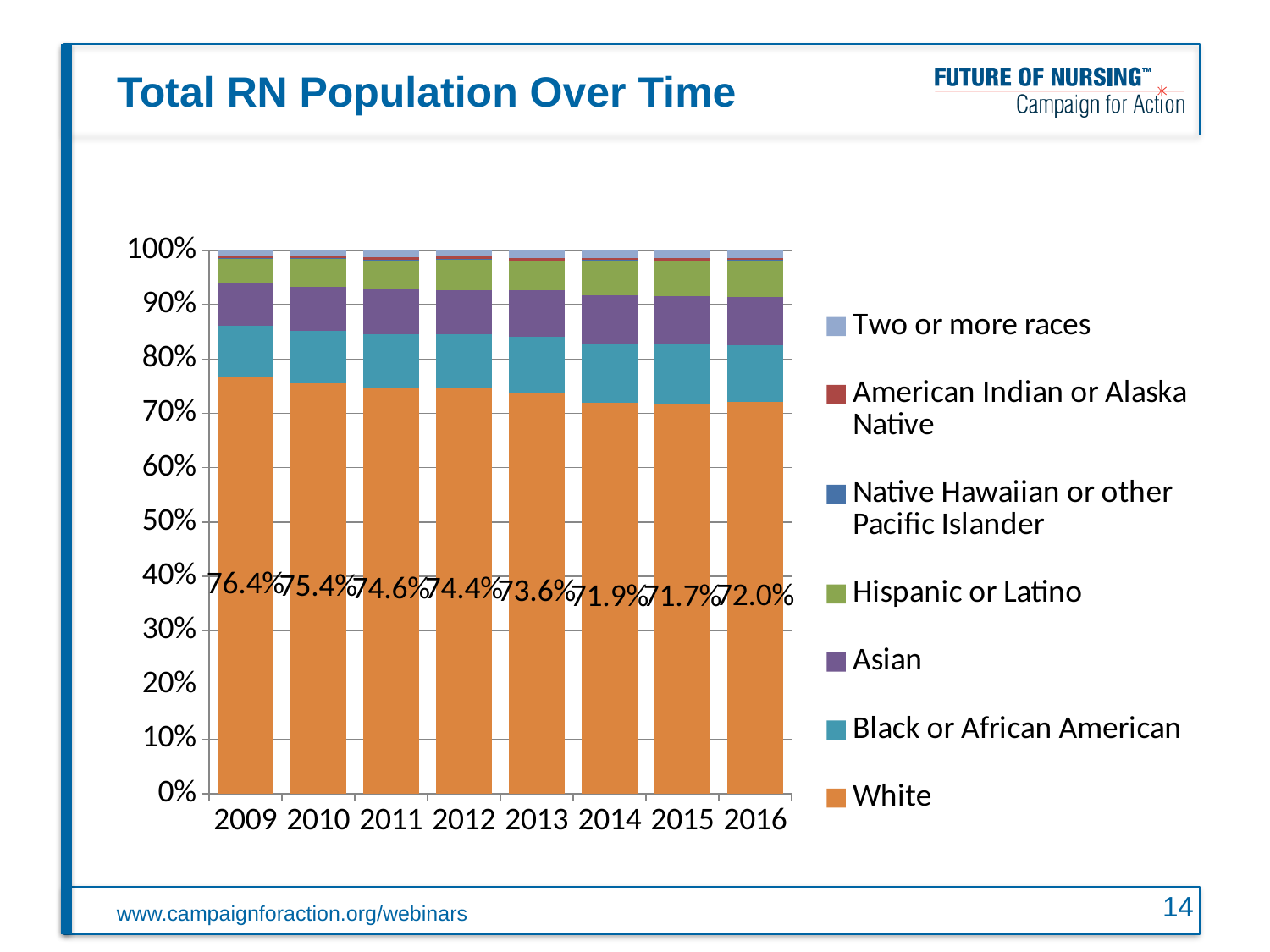
Which is larger, the White share in 2011 or in 2014? 2011 What is the value for White in 2016? 72.0% In which year is the White share lowest? 2015 How many years are shown on the x axis? 8 How many series does the legend list? 7 In which year is the White share highest? 2009 What is the difference between the White share in 2009 and in 2016? 4.4% What is the value for White in 2009? 76.4% What kind of chart is shown? Stacked bar chart Does the White share generally rise or fall from 2009 to 2015? fall Is the White share in 2012 greater or less than 70%? greater What is the value for White in 2013? 73.6%